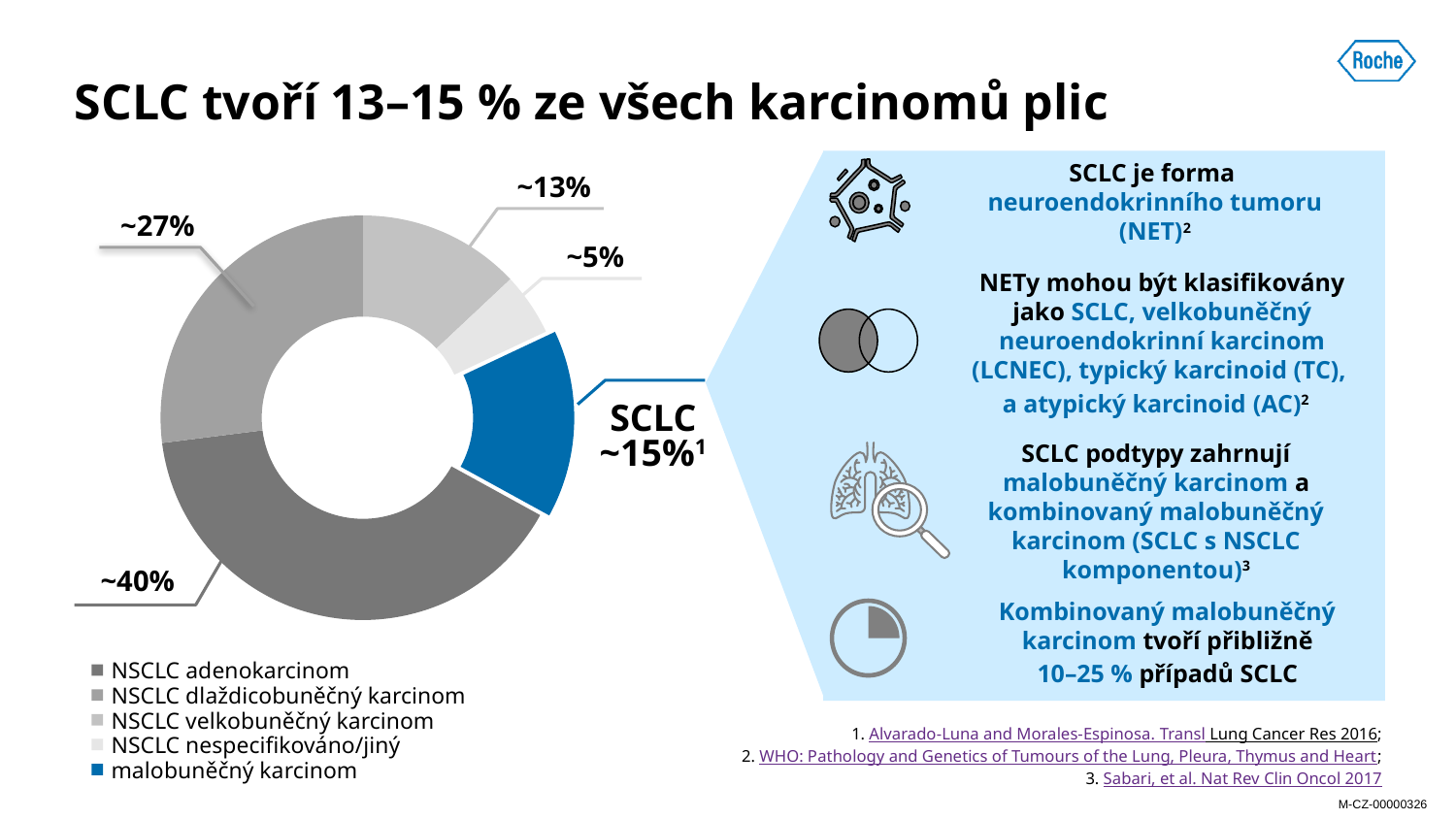
What value is shown for the NSCLC adenokarcinom slice? ~40% How many categories does the legend of the chart list? 5 What type of chart is shown on the slide? Pie (donut) chart What share of lung cancers does the SCLC (malobuněčný karcinom) slice represent? ~15% What value is shown for the NSCLC nespecifikováno/jiný slice? ~5% Which category has the largest slice of the chart? NSCLC adenokarcinom Which legend category is shown in blue? malobuněčný karcinom Which slice is larger: NSCLC dlaždicobuněčný karcinom or malobuněčný karcinom? NSCLC dlaždicobuněčný karcinom What value is shown for the NSCLC dlaždicobuněčný karcinom slice? ~27% What is the title of the slide containing the chart? SCLC tvoří 13–15 % ze všech karcinomů plic Which category has the smallest slice of the chart? NSCLC nespecifikováno/jiný What value is shown for the NSCLC velkobuněčný karcinom slice? ~13%